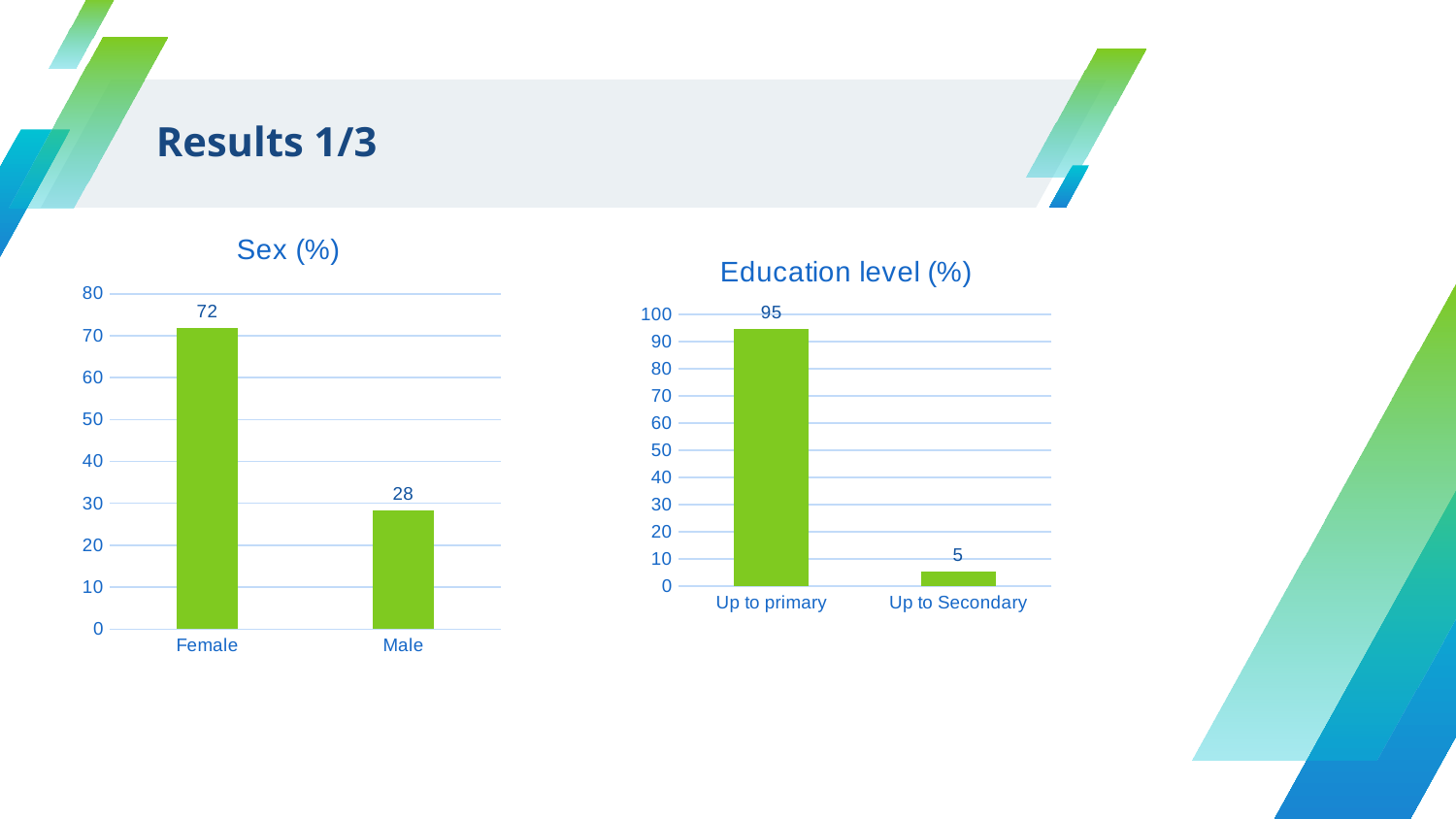
In the 'Education level (%)' chart, what is the value for Up to primary? 95 In the 'Sex (%)' chart, what is the value for Female? 72 In the 'Sex (%)' chart, which category has the highest value? Female What is the title of the chart on the left side of the slide? Sex (%) In the 'Education level (%)' chart, which category has the lowest value? Up to Secondary In the 'Education level (%)' chart, what is the value for Up to Secondary? 5 In the 'Education level (%)' chart, is the value for Up to primary greater or less than 90? greater What kind of chart is the 'Education level (%)' chart? Bar chart In the 'Sex (%)' chart, what is the value for Male? 28 In the 'Sex (%)' chart, how many categories are shown? 2 In the 'Education level (%)' chart, what is the difference between Up to primary and Up to Secondary? 90 In the 'Sex (%)' chart, what is the difference between the Female and Male values? 44